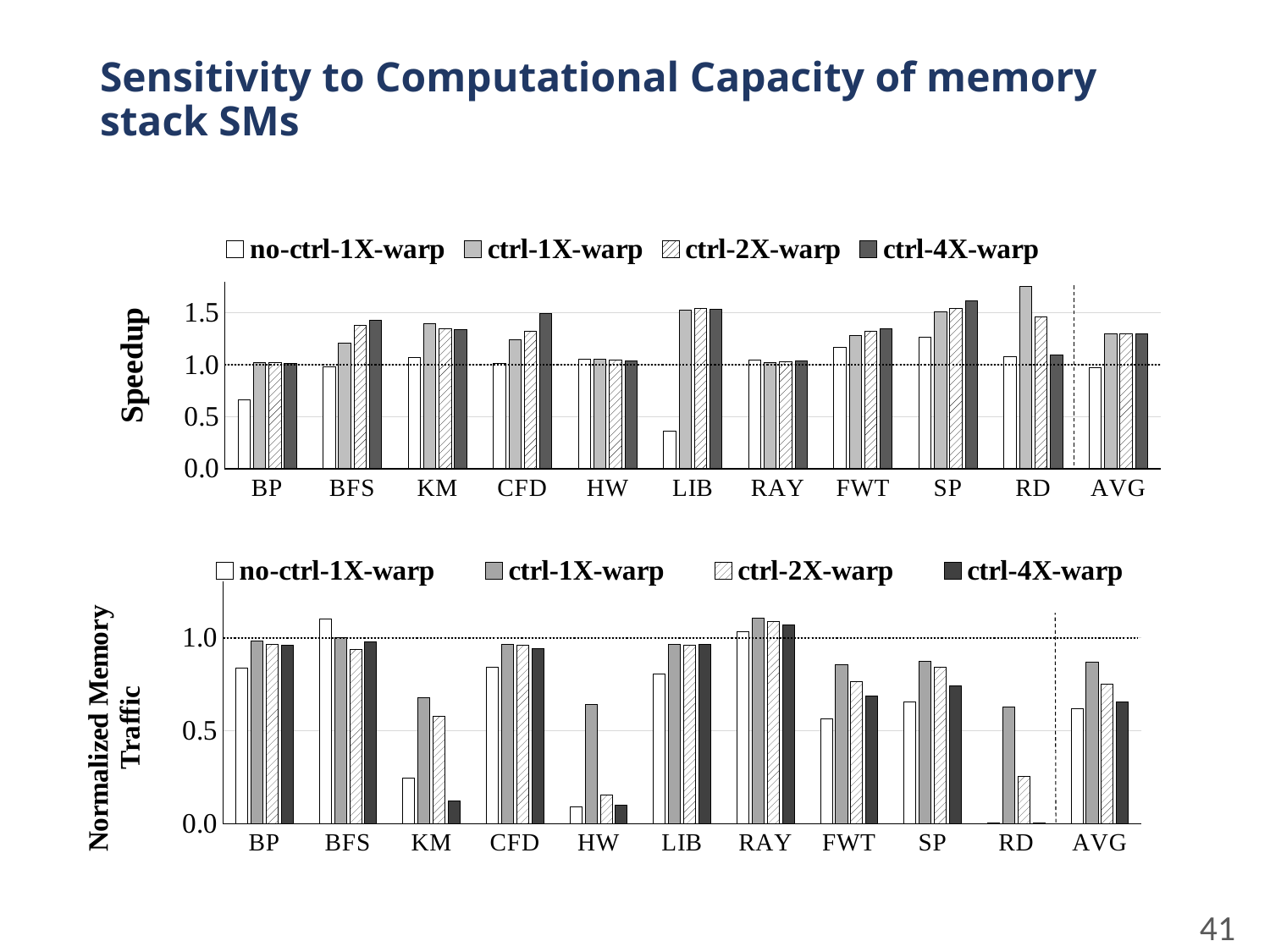
In the bottom chart (Normalized Memory Traffic), is the ctrl-4X-warp value for KM greater or less than 0.5? less In the top chart (Speedup), is the no-ctrl-1X-warp value for LIB greater or less than 0.5? less In the bottom chart (Normalized Memory Traffic), is the ctrl-1X-warp value for AVG greater or less than 0.5? greater In the top chart (Speedup), how many categories are shown on the x axis? 11 In the top chart (Speedup), how many series does the legend list? 4 In the bottom chart (Normalized Memory Traffic), which is larger for KM: ctrl-1X-warp or ctrl-2X-warp? ctrl-1X-warp What is the y-axis label of the bottom chart? Normalized Memory Traffic What kind of chart is the bottom chart (Normalized Memory Traffic)? bar chart In the top chart (Speedup), which category has the tallest bar overall? RD In the top chart (Speedup), which is larger for BP: no-ctrl-1X-warp or ctrl-1X-warp? ctrl-1X-warp In the top chart (Speedup), which category has the shortest bar overall? LIB